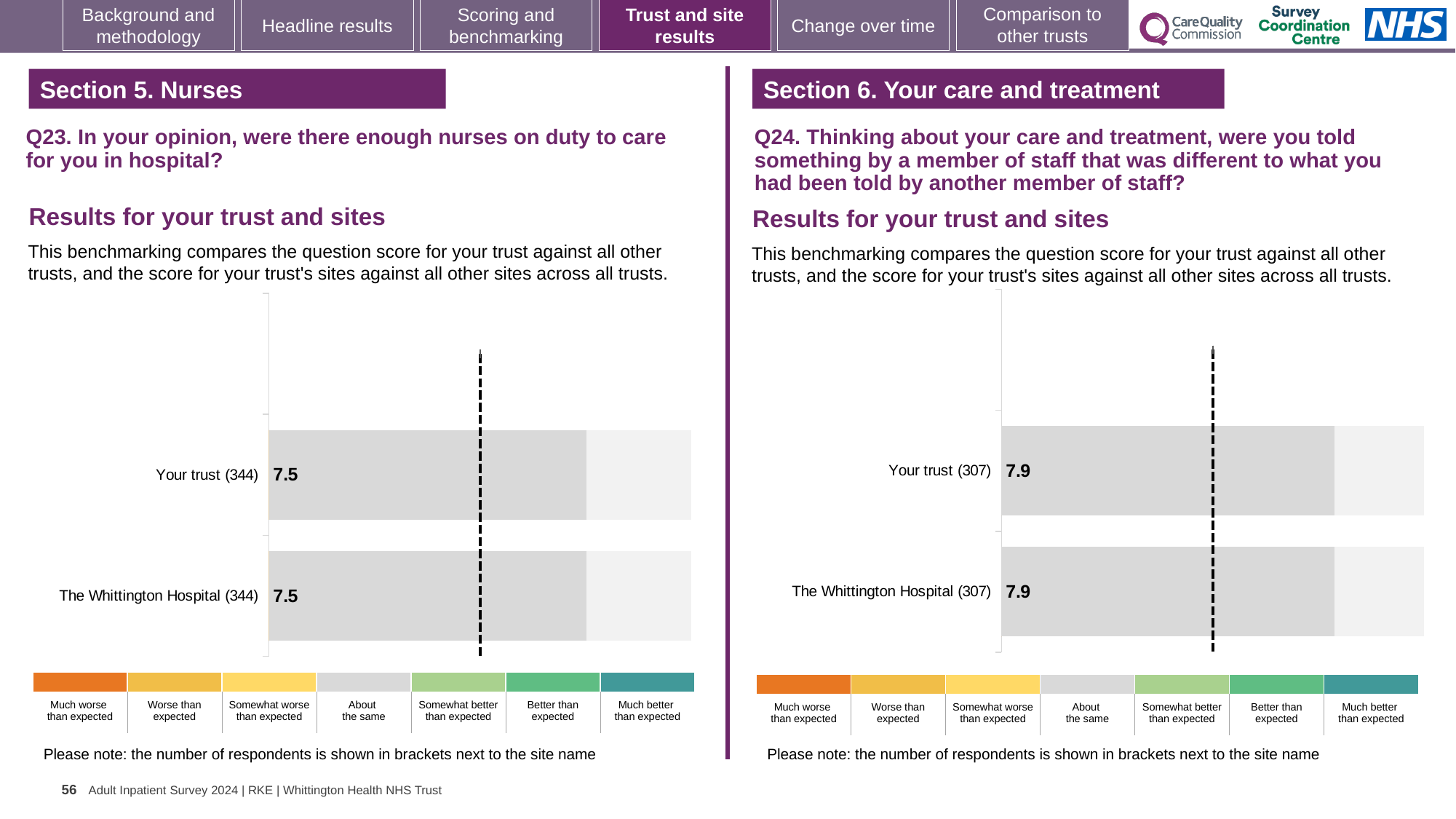
What kind of chart is used on the Q23 chart (left)? Bar chart Is the score for Your trust on the Q24 chart (right) larger or smaller than the score for Your trust on the Q23 chart (left)? Larger On the Q23 chart (left), what is the difference between the score for Your trust and the score for The Whittington Hospital? 0 On the Q23 chart (left), what is the score for The Whittington Hospital (344)? 7.5 On the Q24 chart (right), what is the difference between the score for Your trust and the score for The Whittington Hospital? 0 On the Q23 chart (left), what is the score for Your trust (344)? 7.5 On the Q24 chart (right), what is the score for The Whittington Hospital (307)? 7.9 How many bars are plotted on the Q24 chart (right)? 2 On the Q24 chart (right), what is the score for Your trust (307)? 7.9 On the Q23 chart (left), how many respondents are shown in brackets next to The Whittington Hospital? 344 How many bars are plotted on the Q23 chart (left)? 2 On the Q24 chart (right), how many respondents are shown in brackets next to Your trust? 307